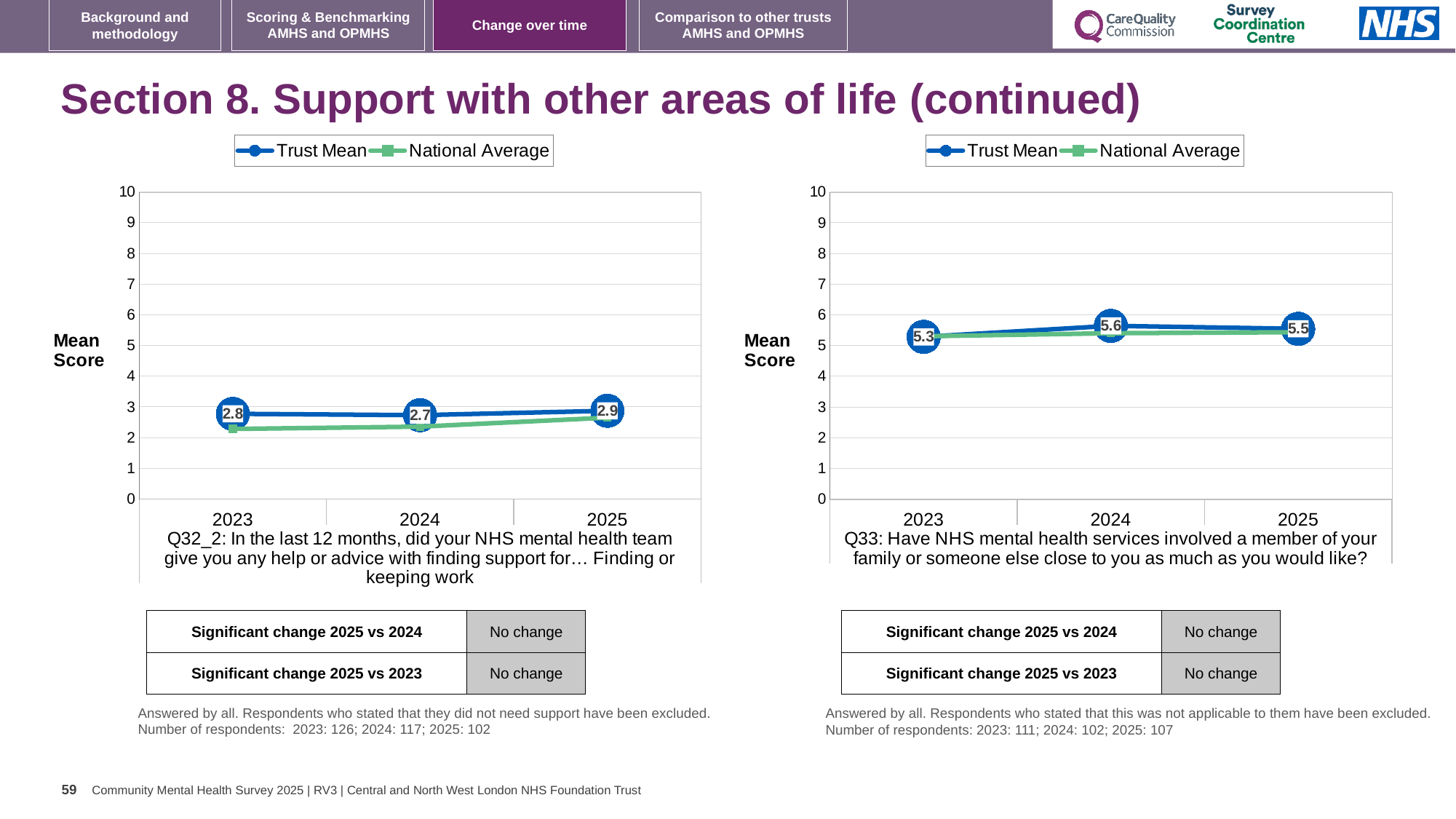
In the right chart (Q33), what is the difference between the Trust Mean for 2024 and the Trust Mean for 2023? 0.3 In the left chart (Q32_2), is the Trust Mean for 2025 larger or smaller than the Trust Mean for 2024? larger How many years are plotted on the x axis of the left chart (Q32_2)? 3 In the left chart (Q32_2), what is the Trust Mean for 2025? 2.9 In the right chart (Q33), what is the Trust Mean for 2023? 5.3 In the left chart (Q32_2), what is the Trust Mean for 2024? 2.7 In the right chart (Q33), is the National Average for 2023 greater or less than 4? greater What kind of chart is the right chart (Q33)? line chart In the right chart (Q33), which year has the highest Trust Mean? 2024 In the left chart (Q32_2), is the National Average for 2023 greater or less than 3? less How many series does the legend of the right chart (Q33) list? 2 In the left chart (Q32_2), which year has the lowest Trust Mean? 2024